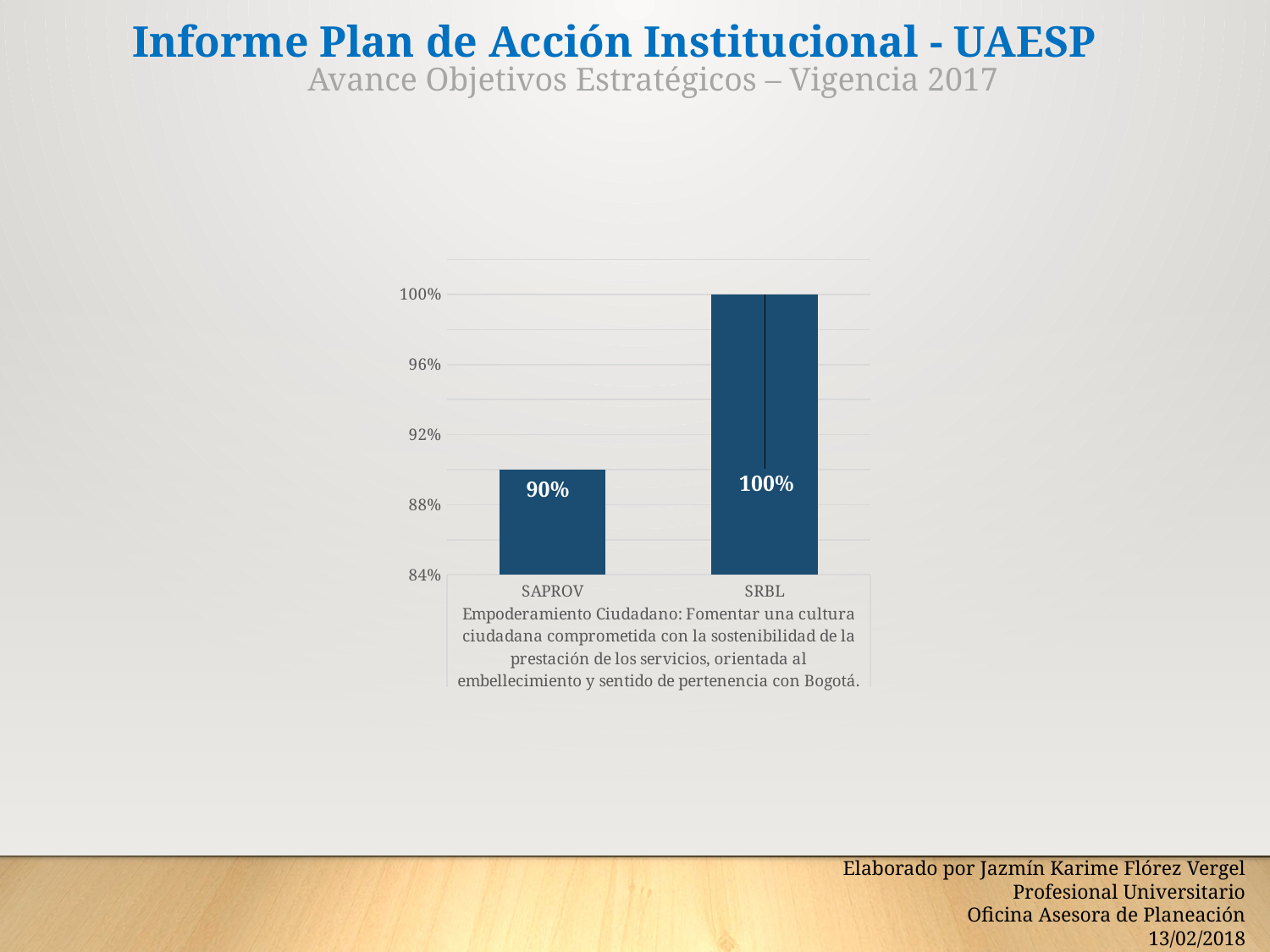
How many categories are shown in the chart? 2 What is the difference between the values for SRBL and SAPROV? 10% Is the value for SRBL greater or less than 96%? greater Which category has the highest value? SRBL What is the value for SAPROV? 90% What kind of chart is shown on the slide? bar chart Is the value for SAPROV greater or less than 92%? less Do the values rise or fall from SAPROV to SRBL? rise What is the value for SRBL? 100% Which is larger, the value for SAPROV or the value for SRBL? SRBL What is the lowest value shown on the vertical axis of the chart? 84% Which category has the lowest value? SAPROV